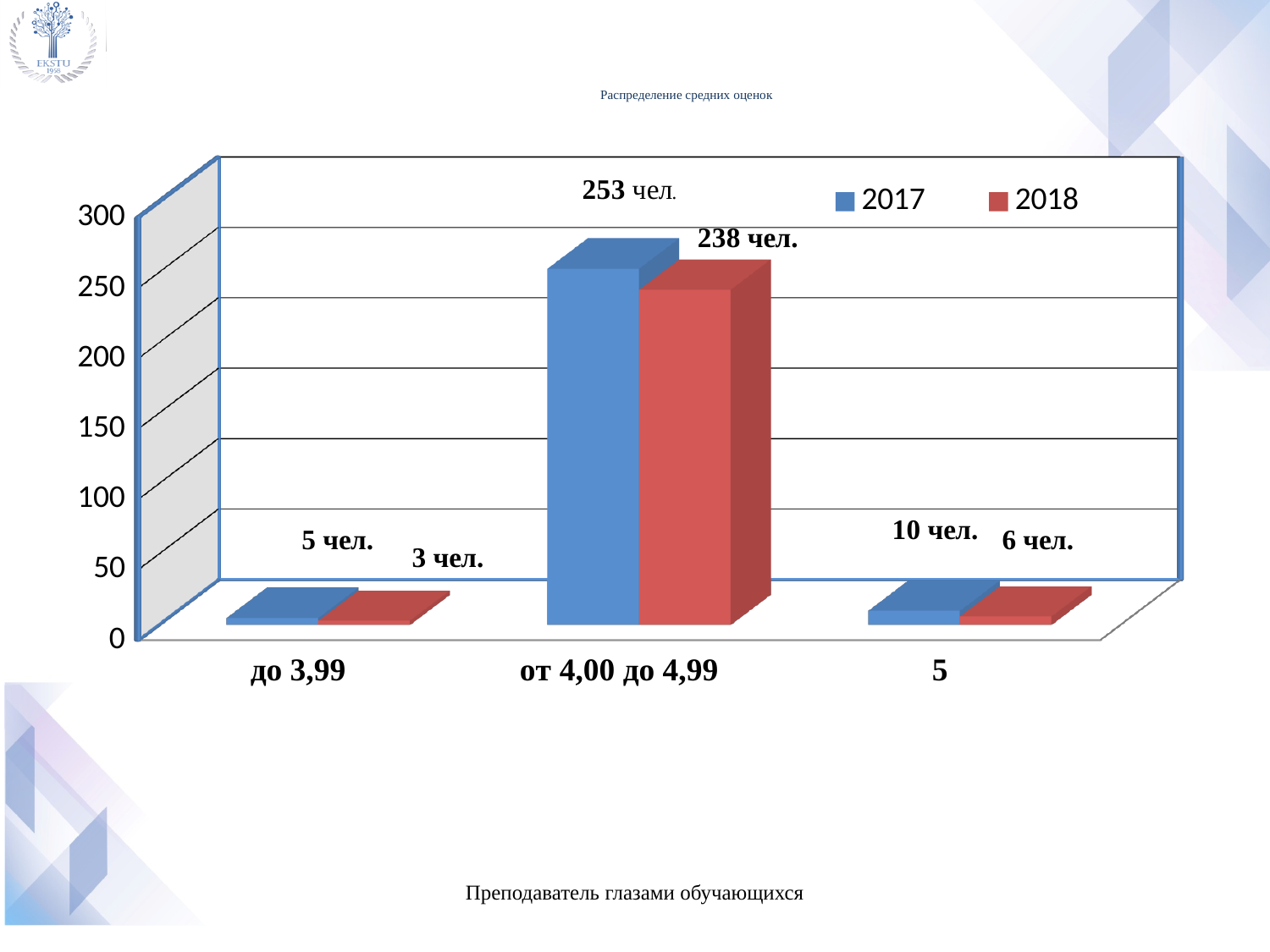
What kind of chart is shown on the slide? bar chart How many series does the legend list? 2 Which category has the highest value for 2017? от 4,00 до 4,99 What is the value for 2017 in the category "до 3,99"? 5 чел. What is the difference between the 2017 and 2018 values in the category "от 4,00 до 4,99"? 15 чел. What is the value for 2018 in the category "от 4,00 до 4,99"? 238 чел. How many categories are shown on the x axis? 3 Is the value for 2018 in the category "от 4,00 до 4,99" greater or less than 200? greater What is the value for 2017 in the category "от 4,00 до 4,99"? 253 чел. Which category has the lowest value for 2018? до 3,99 What is the value for 2018 in the category "5"? 6 чел. In the category "5", which series has the larger value, 2017 or 2018? 2017